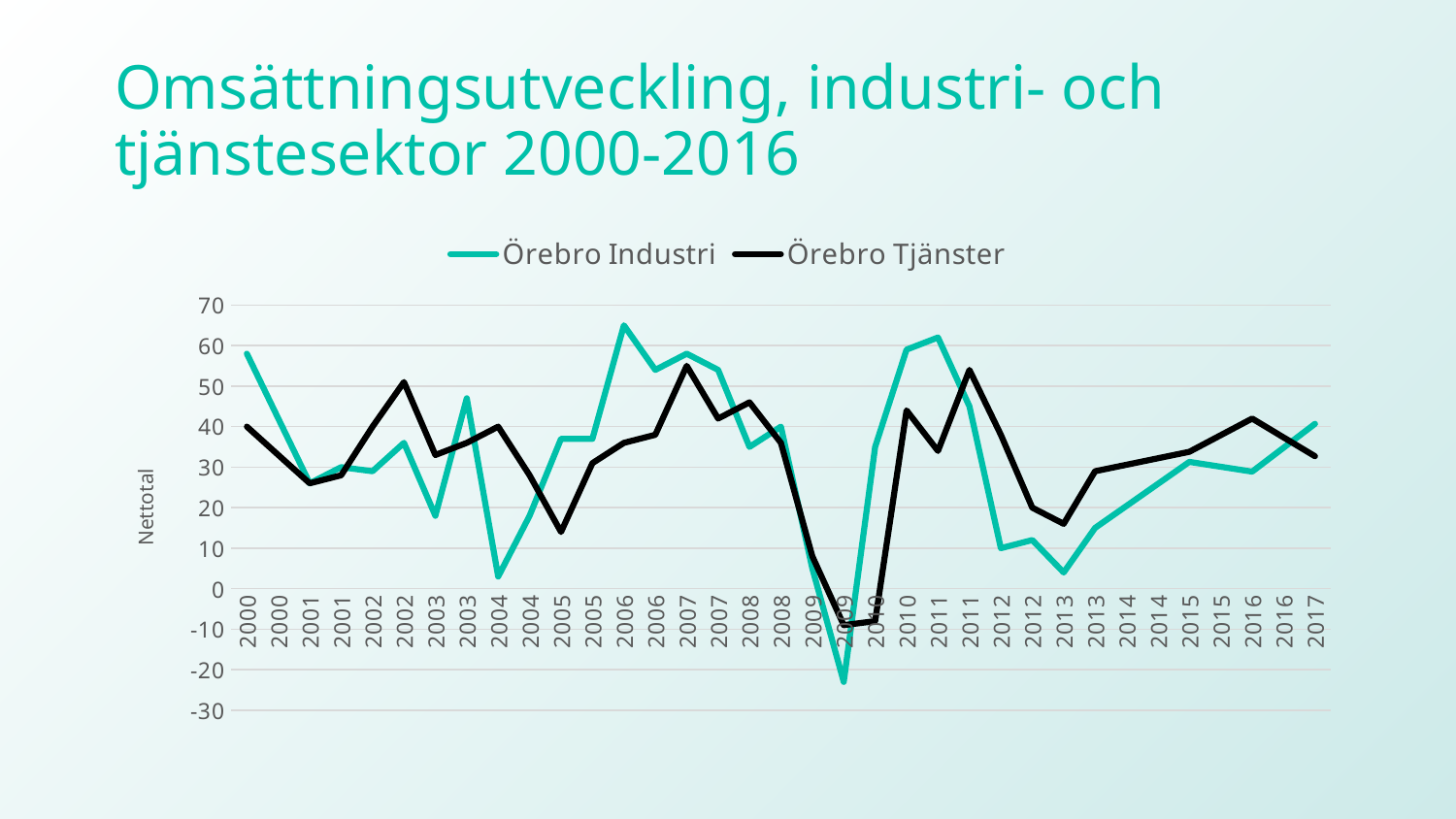
Which series reaches the highest value anywhere on the chart? Örebro Industri What is the label on the vertical axis? Nettotal Is the peak value for Örebro Industri in 2006 greater or less than 60? greater At the first 2000 point, which series has the higher value, Örebro Industri or Örebro Tjänster? Örebro Industri Which series reaches the lowest value anywhere on the chart? Örebro Industri What are the two series named in the legend? Örebro Industri and Örebro Tjänster What kind of chart is shown on the slide? line chart Is the value for Örebro Industri at the first 2000 point greater or less than 50? greater At the first 2004 point, which series has the higher value, Örebro Industri or Örebro Tjänster? Örebro Tjänster Is the lowest value for Örebro Industri in 2009 greater or less than 0? less How many series does the legend list? 2 Do both series rise or fall between 2008 and 2009? fall